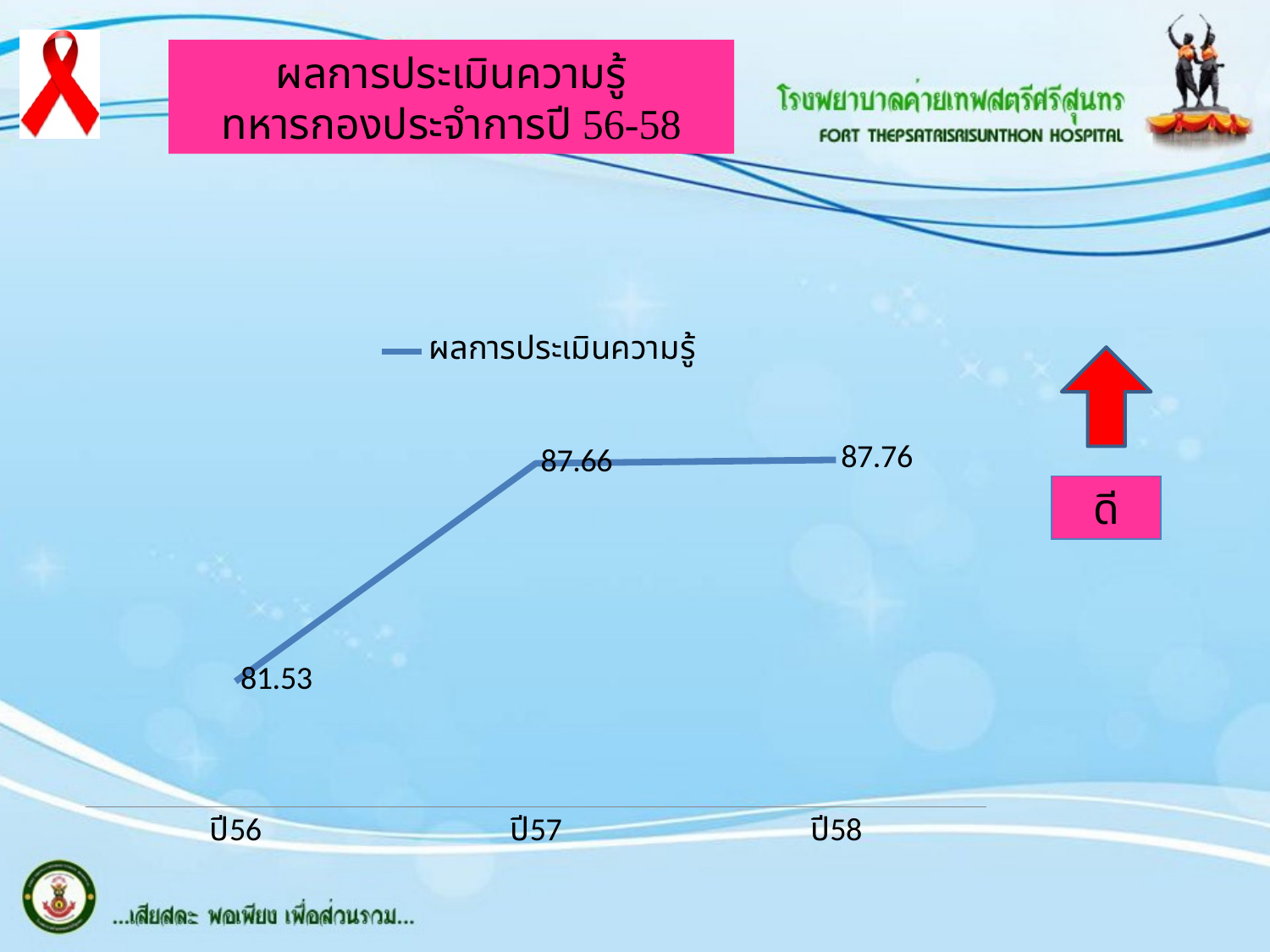
How many series does the legend list? 1 What kind of chart is shown on the slide? line chart How many years are plotted on the chart? 3 Do the values rise or fall from ปี56 to ปี58? rise What is the value for ปี57? 87.66 What is the value for ปี58? 87.76 What is the value for ปี56? 81.53 Which is larger, the value for ปี57 or the value for ปี56? ปี57 What is the difference between the values for ปี57 and ปี56? 6.13 What is the difference between the values for ปี58 and ปี56? 6.23 Which year has the highest value? ปี58 Which year has the lowest value? ปี56